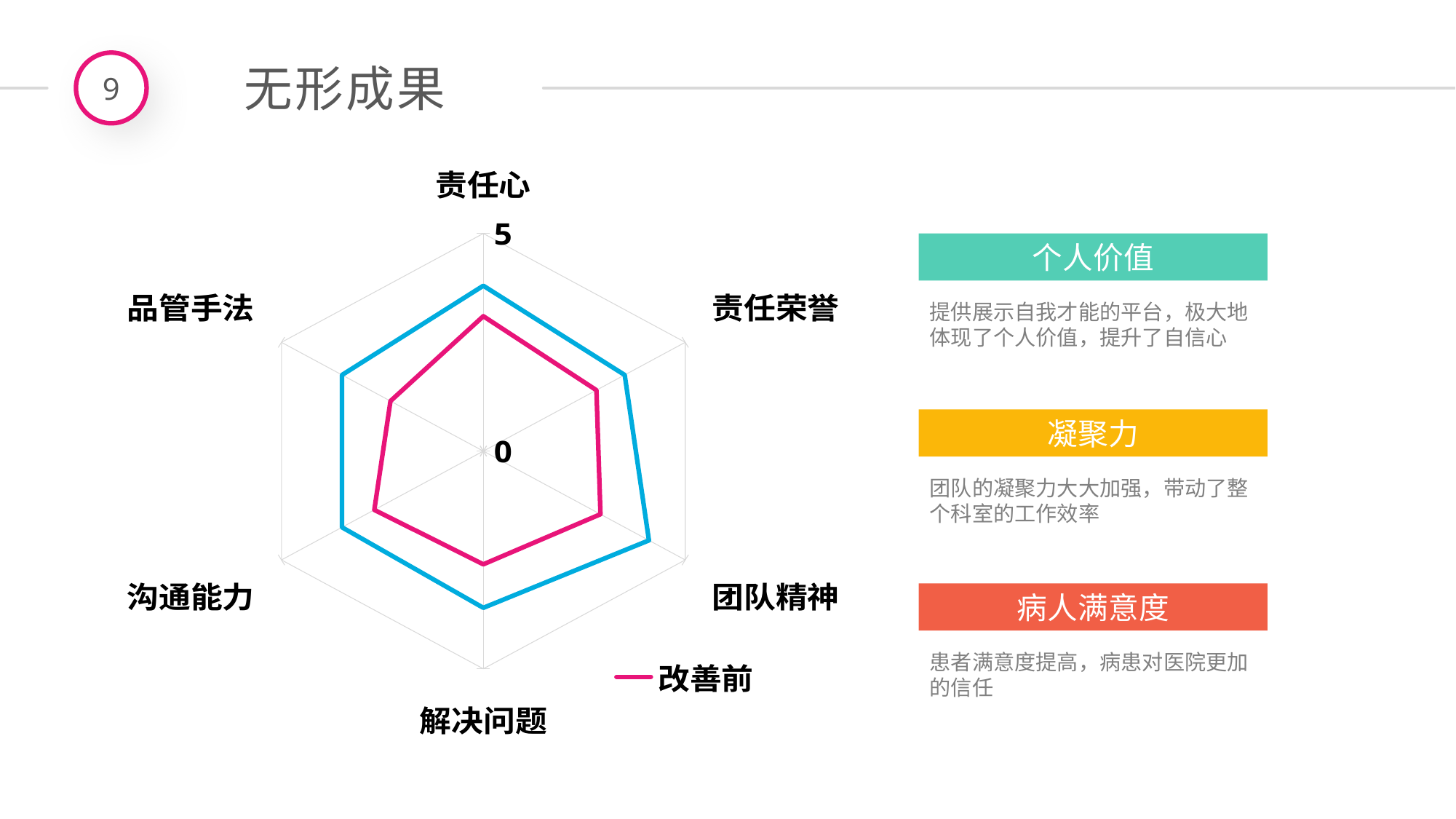
For 团队精神, which line has the larger value, the blue line or the pink 改善前 line? the blue line How many categories (axes) does the radar chart have? 6 Is the 改善前 value for 责任心 greater or less than 5? less Which category label appears at the bottom of the radar chart? 解决问题 For 责任心, which line has the larger value, the blue line or the pink 改善前 line? the blue line What kind of chart is shown on the slide? radar chart On the blue line, which category has the highest value? 团队精神 Is the blue line's value for 团队精神 greater or less than 5? less What is the maximum value shown on the radar chart's axis? 5 What is the series name shown in the chart legend? 改善前 Which category label appears at the top of the radar chart? 责任心 How many series does the chart legend list? 1